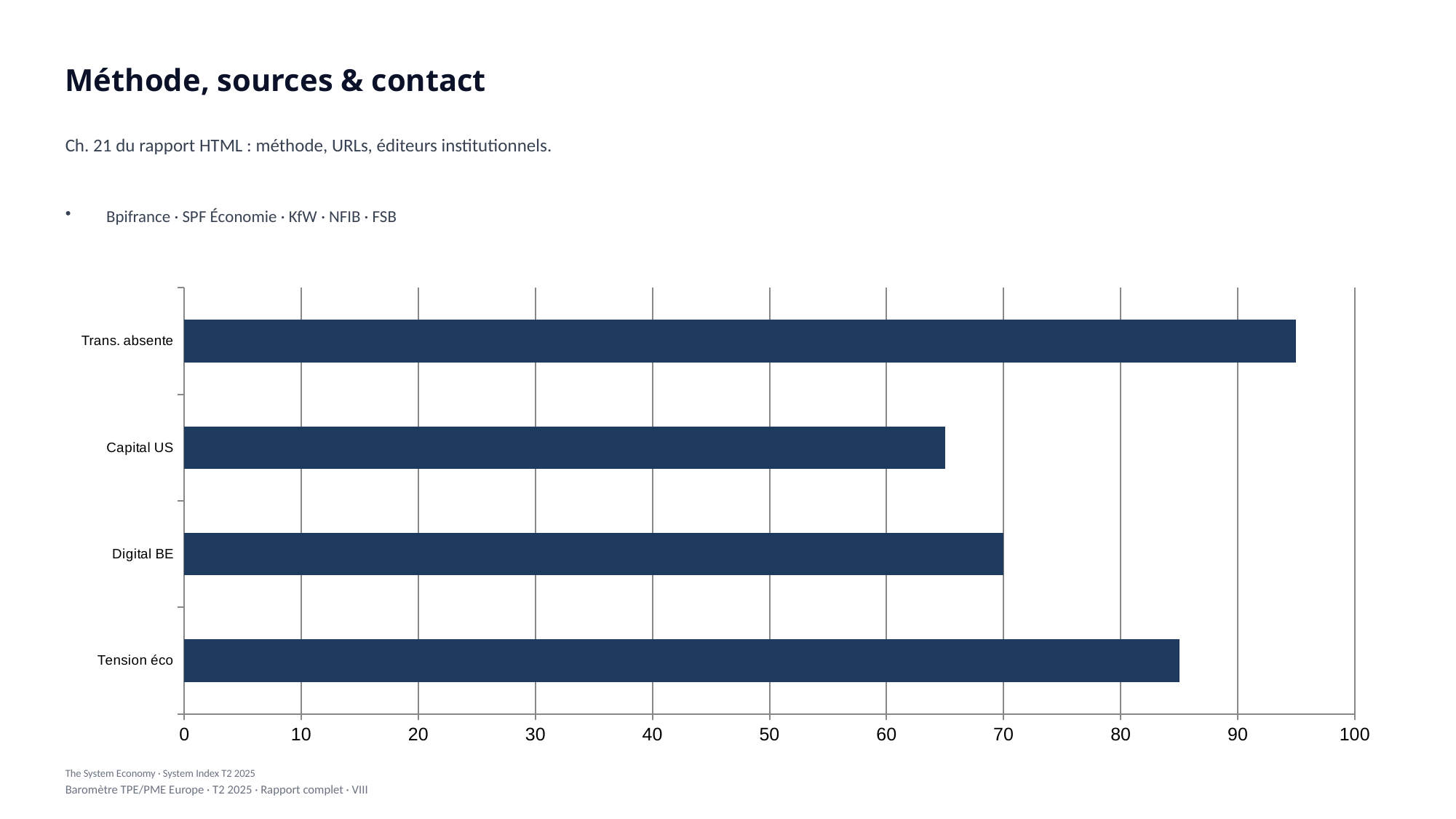
Is the value for Capital US greater or less than 60? greater Which category has the lowest value in the bar chart? Capital US Is the value for Tension éco greater or less than 80? greater How many categories are plotted in the bar chart? 4 Is the value for Trans. absente greater or less than 90? greater Which is larger, the value for Tension éco or the value for Digital BE? Tension éco Which category has the highest value in the bar chart? Trans. absente What is the value for Digital BE? 70 What colour are the bars in the chart? dark navy blue What kind of chart is shown on the slide? bar chart Which is larger, the value for Capital US or the value for Trans. absente? Trans. absente